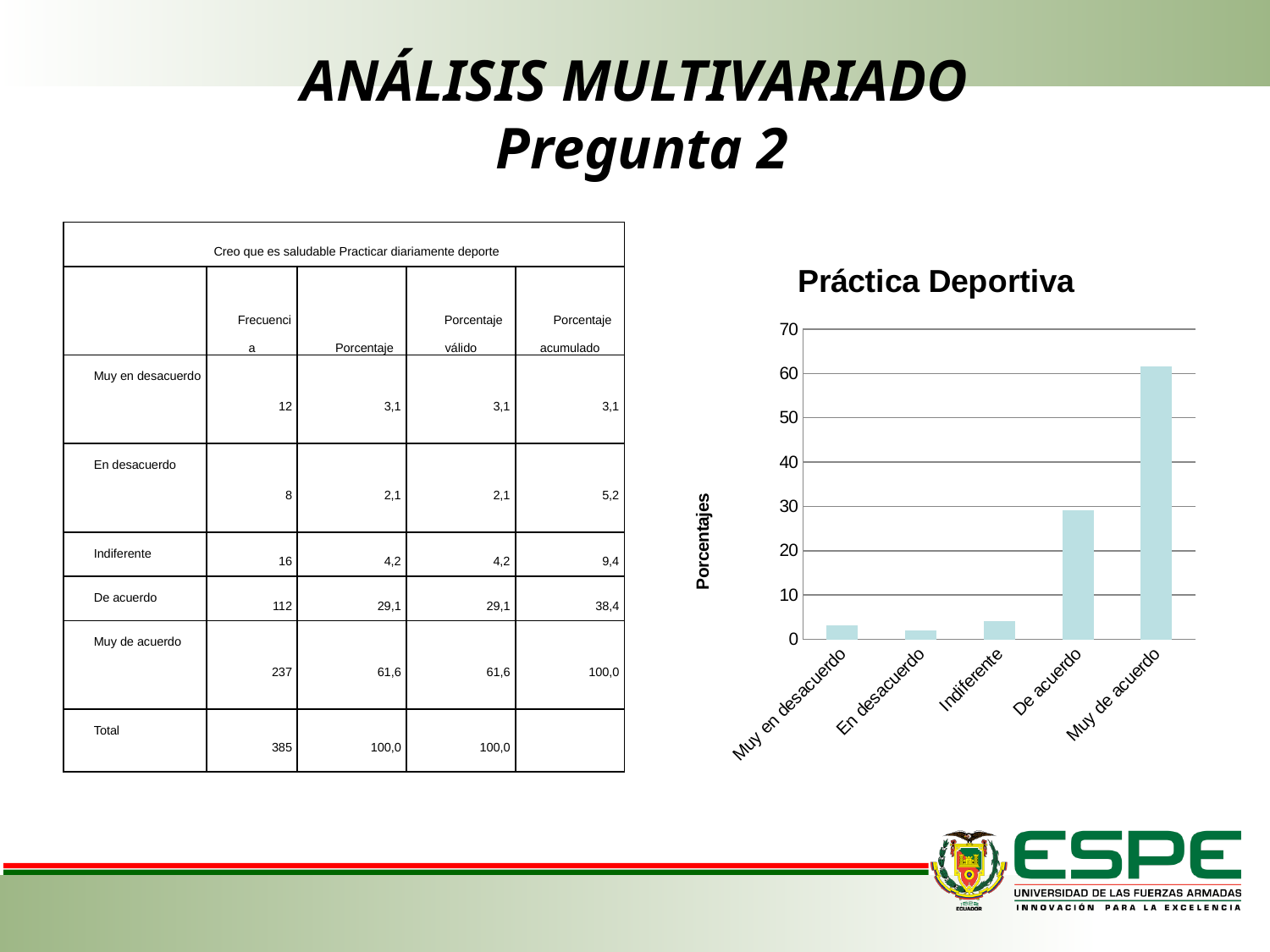
Is the value for Indiferente in the "Práctica Deportiva" chart greater or less than 10? less Is the value for De acuerdo in the "Práctica Deportiva" chart greater or less than 40? less What is the highest tick value shown on the vertical axis of the "Práctica Deportiva" chart? 70 Which category has the highest bar in the "Práctica Deportiva" chart? Muy de acuerdo In the "Práctica Deportiva" chart, which bar is taller: Indiferente or De acuerdo? De acuerdo Is the value for Muy de acuerdo in the "Práctica Deportiva" chart greater or less than 50? greater What kind of chart is shown under the title "Práctica Deportiva"? bar chart How many categories are plotted on the x axis of the "Práctica Deportiva" chart? 5 What is the label on the vertical axis of the "Práctica Deportiva" chart? Porcentajes In the "Práctica Deportiva" chart, which bar is taller: De acuerdo or Muy de acuerdo? Muy de acuerdo Do the bars in the "Práctica Deportiva" chart generally rise or fall from left to right along the x axis? rise